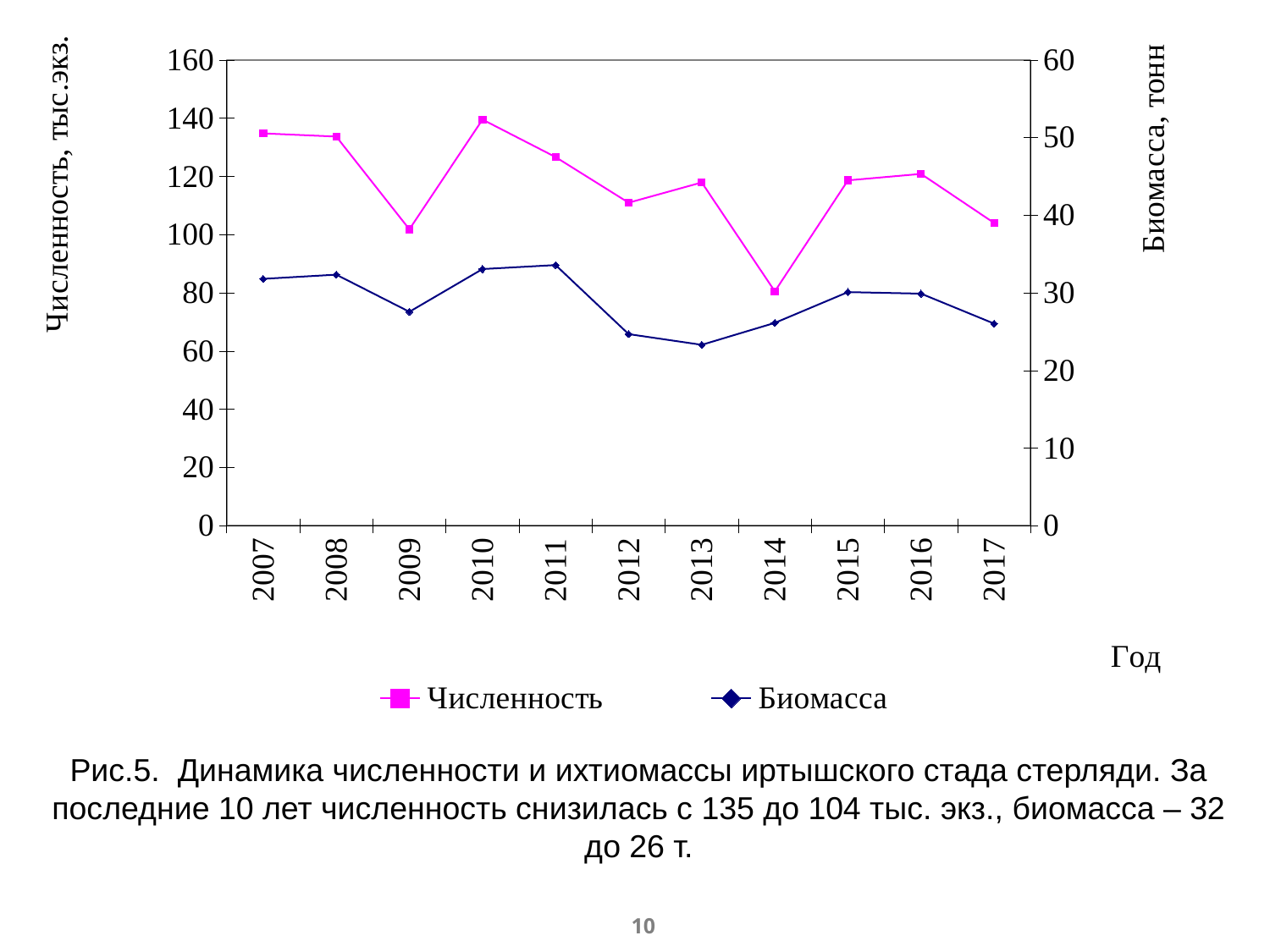
In which year is the Численность series at its highest? 2010 In which year is the Биомасса series at its lowest? 2013 How many years are plotted along the x axis? 11 Is the Биомасса value for 2011 greater or less than 30? greater Is the Численность value for 2010 greater or less than 120? greater According to the caption, what was the Численность value in 2017? 104 тыс. экз. In which year is the Численность series at its lowest? 2014 What type of chart is shown on the slide? line chart Does the Численность series overall rise or fall from 2007 to 2017? fall Is the Численность value for 2014 greater or less than 100? less How many series does the legend list? 2